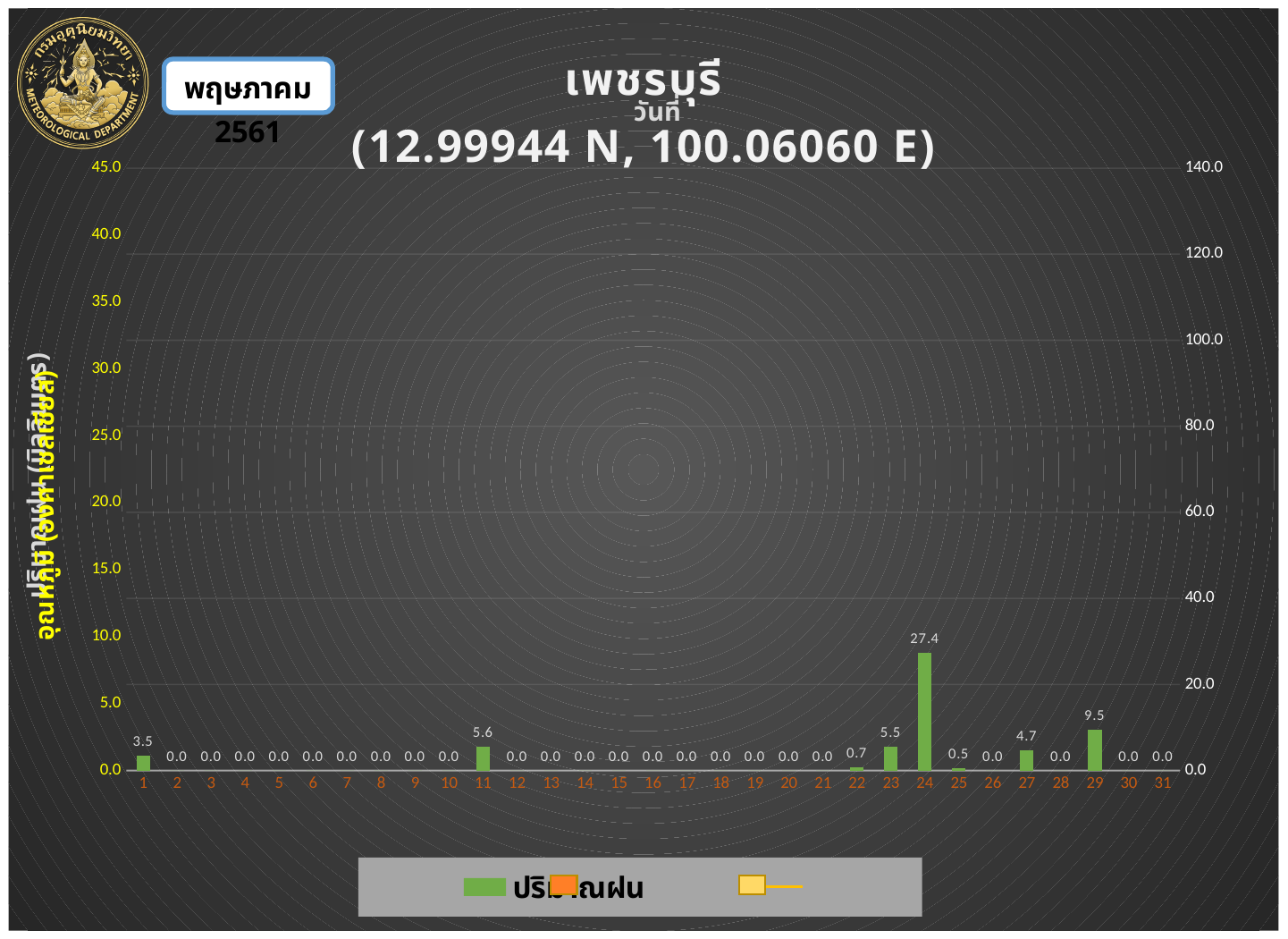
What kind of chart is shown on the slide? Bar chart Which day has the highest rainfall value? 24 What is the rainfall value shown for day 1? 3.5 Which has the larger rainfall value, day 29 or day 27? Day 29 What is the rainfall value shown for day 24? 27.4 What is the highest value labelled on the left y axis? 45.0 What is the rainfall value shown for day 29? 9.5 What is the difference between the rainfall values for day 24 and day 29? 17.9 Is the rainfall value for day 24 greater or less than 20.0? greater How many days have a rainfall value greater than 0.0? 8 How many days are shown on the x axis? 31 What is the rainfall value shown for day 11? 5.6